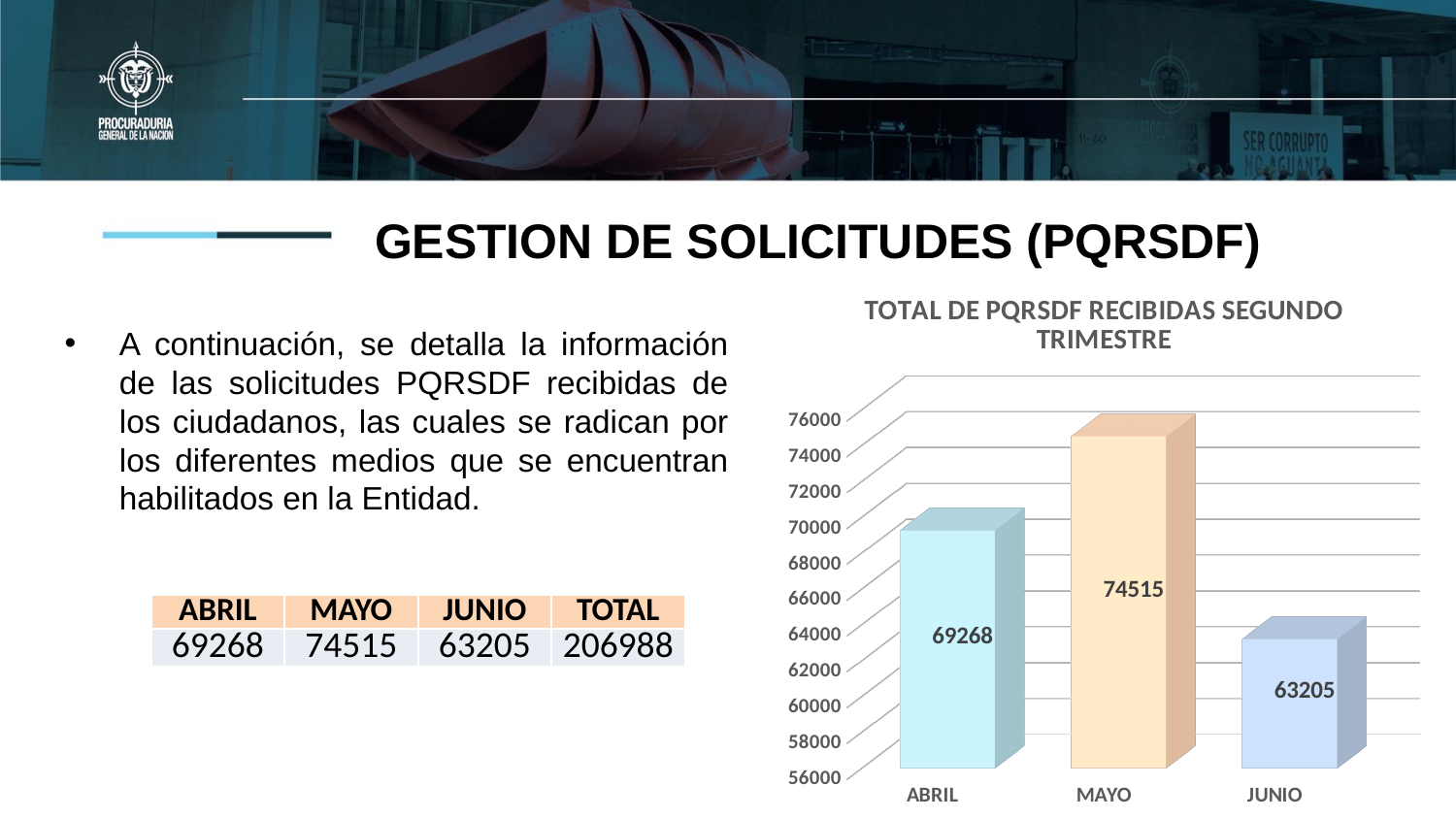
How many months are shown in the chart? 3 What is the difference between the values for ABRIL and JUNIO? 6063 What kind of chart is shown on the slide? bar chart What is the difference between the values for MAYO and JUNIO? 11310 Which is larger, the value for ABRIL or the value for JUNIO? ABRIL Is the value for MAYO greater or less than 72000? greater What is the value for JUNIO in the chart? 63205 What is the value for ABRIL in the chart? 69268 What is the title of the chart? TOTAL DE PQRSDF RECIBIDAS SEGUNDO TRIMESTRE Which month has the highest value in the chart? MAYO Which month has the lowest value in the chart? JUNIO What is the value for MAYO in the chart? 74515